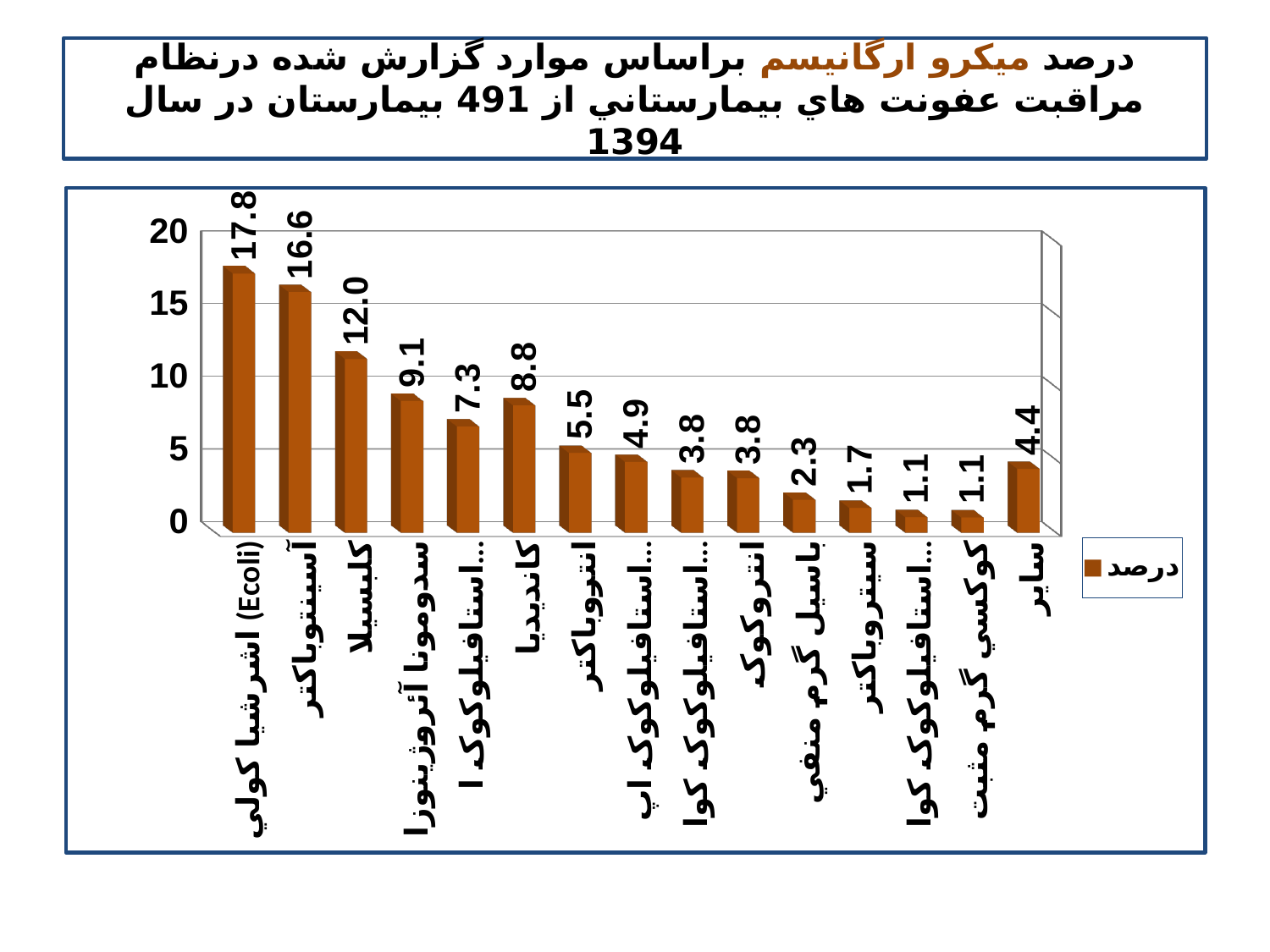
How many series does the legend list? 1 Which category has the highest value? اشرشیا کولی (Ecoli) What is the legend entry for the series? درصد How many categories are plotted in the chart? 15 What is the value for اشرشیا کولی (Ecoli)? 17.8 What type of chart is shown on the slide? bar chart What is the value for آسینتوباکتر? 16.6 What is the value for کلبسیلا? 12.0 What is the value for کاندیدا? 8.8 Which is larger, the value for کاندیدا or the value for انتروباکتر? کاندیدا What is the value for سایر? 4.4 What is the difference between the values for اشرشیا کولی (Ecoli) and آسینتوباکتر? 1.2